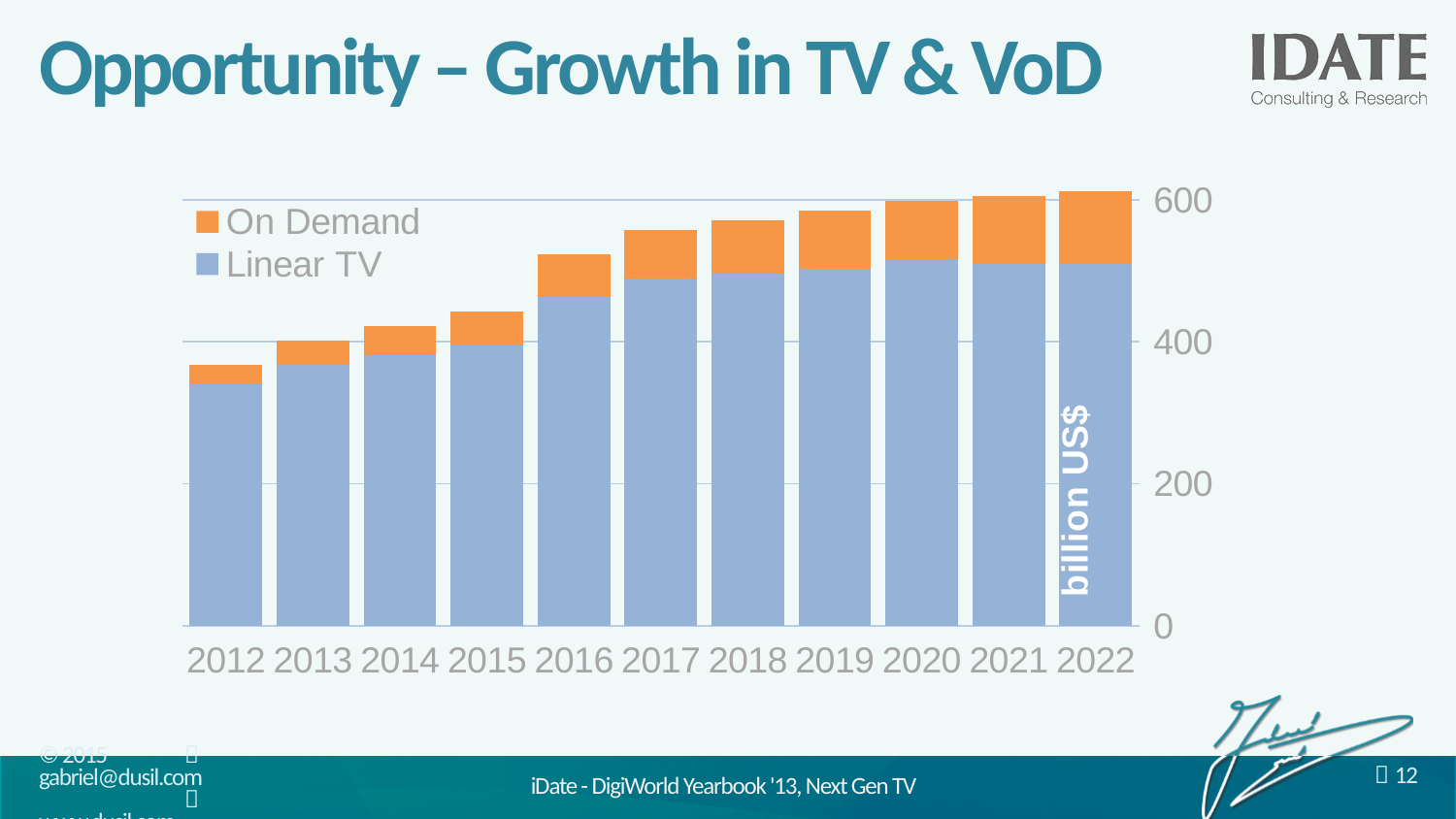
Which series is shown in orange? On Demand Which year has the highest total bar? 2022 Which year has the lowest total bar? 2012 Which is larger, the total bar for 2012 or the total bar for 2022? 2022 How many series does the legend list? 2 How many years are shown on the x axis? 11 Is the Linear TV value for 2012 greater or less than 200? greater What unit is shown on the y axis label? billion US$ Do the total values rise or fall from 2012 to 2022? Rise Is the total value for 2016 greater or less than 400? greater Is the total value for 2012 greater or less than 400? less What kind of chart is shown on the slide? Stacked bar chart